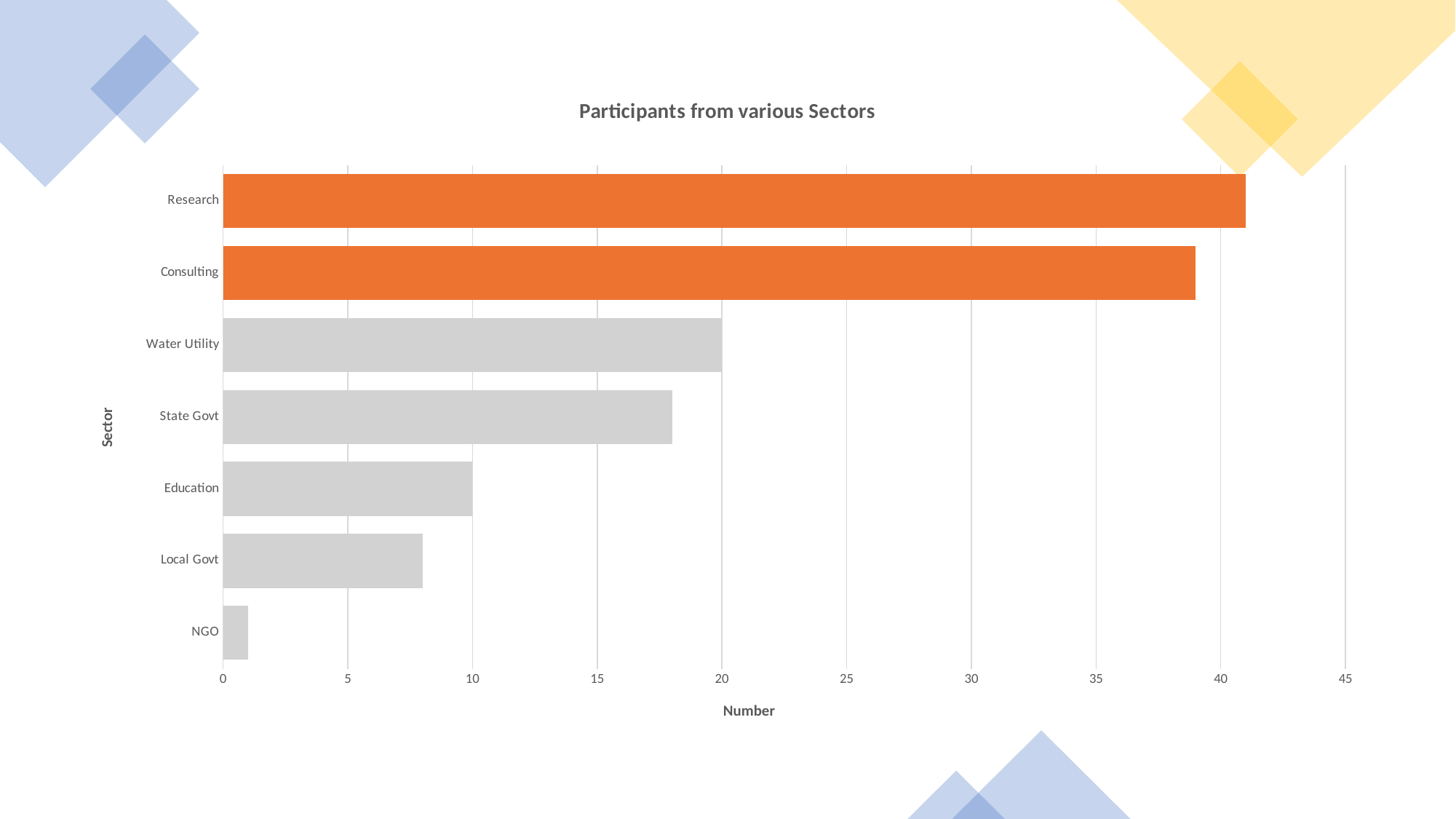
What is the value for Water Utility? 20 Is the value for Consulting greater or less than 40? less Which has more participants, State Govt or Education? State Govt What is the value for Education? 10 What is the label of the horizontal axis? Number What is the title of the chart? Participants from various Sectors Is the value for Research greater or less than 40? greater Which sector has the highest number of participants? Research What kind of chart is shown on the slide? bar chart Which sector has the lowest number of participants? NGO How many sectors are shown in the chart? 7 Is the value for Local Govt greater or less than 5? greater